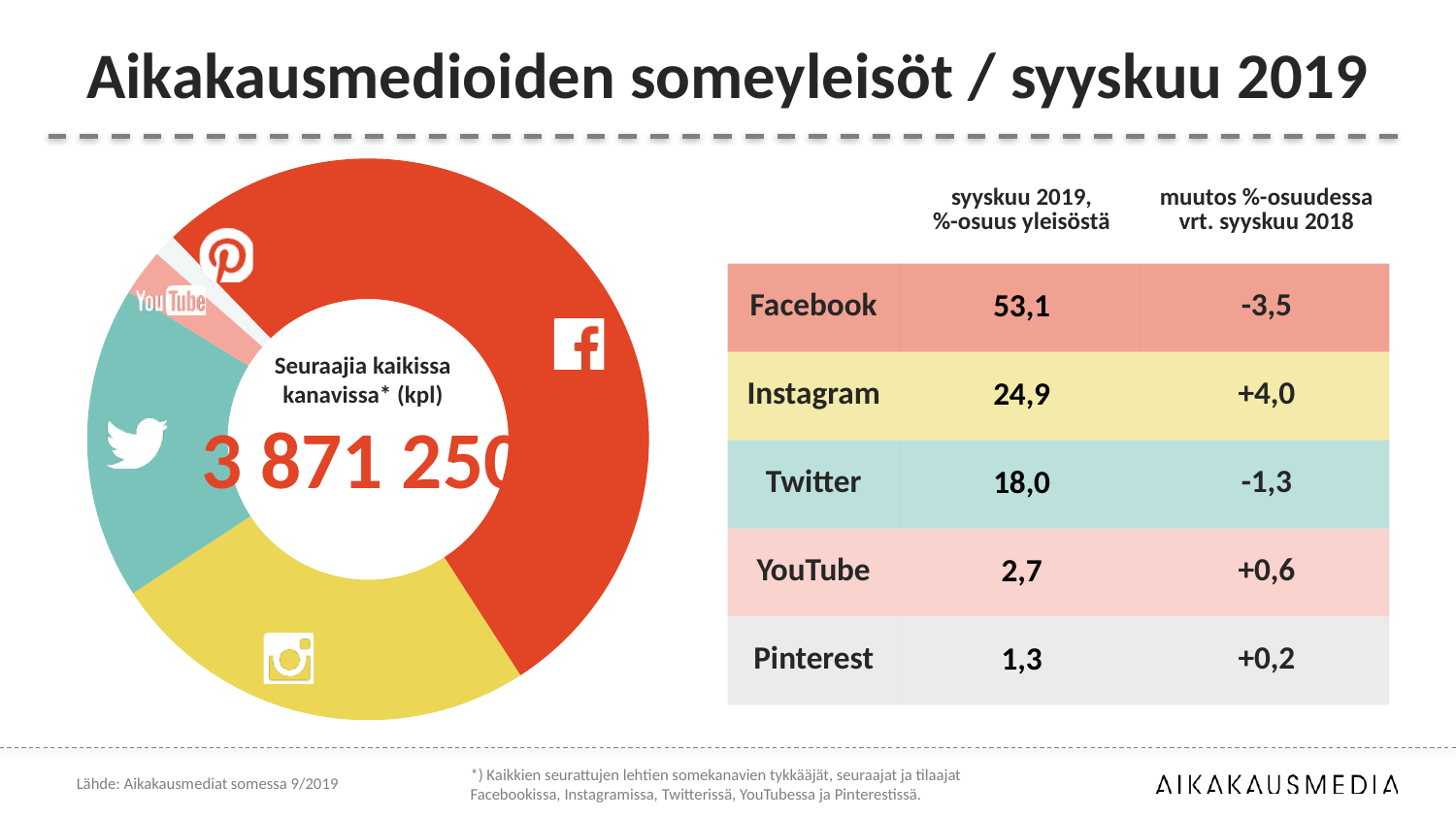
What is Facebook's share of the audience in September 2019 (syyskuu 2019, %-osuus yleisöstä)? 53,1 What is Instagram's share of the audience in September 2019? 24,9 What is the change in Twitter's share compared with September 2018 (muutos %-osuudessa vrt. syyskuu 2018)? -1,3 Which channel has the largest slice of the donut chart? Facebook What is the total number of followers across all channels shown in the centre of the donut chart? 3 871 250 Which is larger, Twitter's share or YouTube's share of the audience in September 2019? Twitter What kind of chart is shown on the left of the slide? Donut (pie) chart How many social media channels are shown as slices in the donut chart? 5 Which channel's slice is coloured yellow in the donut chart? Instagram What is the difference between Facebook's and Instagram's share of the audience in September 2019? 28,2 Which channel has the smallest slice of the donut chart? Pinterest What is the change in Instagram's share compared with September 2018? +4,0